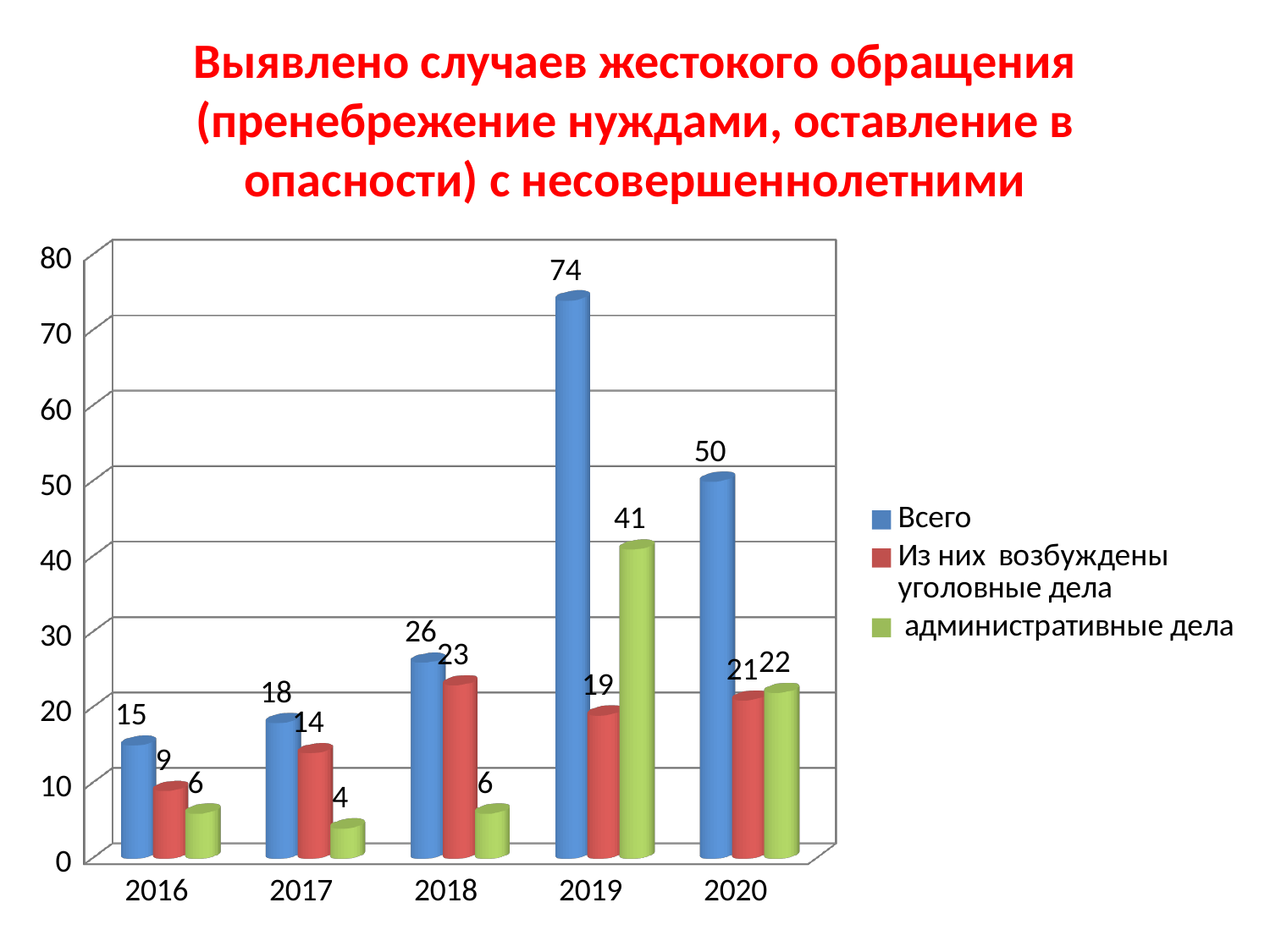
What is the difference between the "Всего" values for 2019 and 2020? 24 In which year is the "административные дела" value lowest? 2017 How many years are shown on the x axis? 5 Does the "Всего" series rise or fall from 2016 to 2019? Rise What kind of chart is shown on the slide? Bar chart How many series does the legend list? 3 Which is larger in 2018: "Из них возбуждены уголовные дела" or "административные дела"? Из них возбуждены уголовные дела What is the value of "Из них возбуждены уголовные дела" for 2017? 14 In which year is the "Всего" value highest? 2019 What is the value of "Всего" for 2019? 74 What colour are the bars for the "Всего" series? Blue What is the value of "административные дела" for 2020? 22